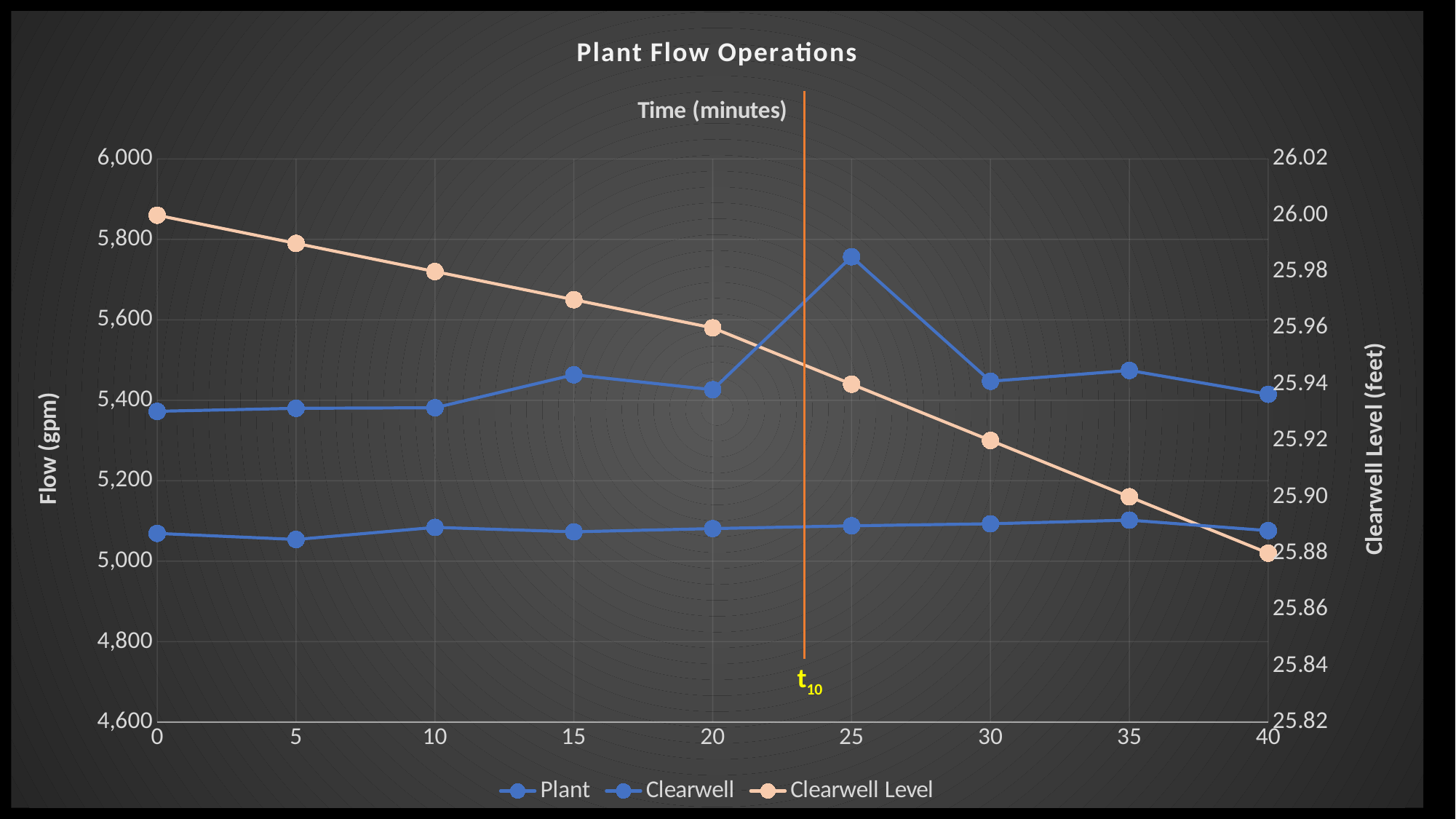
At which time is the Clearwell Level highest? 0 Is the value of the upper blue flow line at 25 minutes greater or less than 5,600? greater How many time points are plotted along the x axis? 9 How many series does the legend list? 3 What is the label of the right-hand vertical axis? Clearwell Level (feet) At which time is the Clearwell Level lowest? 40 Does the Clearwell Level rise or fall as time increases from 0 to 40 minutes? fall What is the title of the chart? Plant Flow Operations What is the Clearwell Level at 20 minutes? 25.96 What is the Clearwell Level at 0 minutes? 26.00 What kind of chart is shown on the slide? line chart What is the Clearwell Level at 40 minutes? 25.88